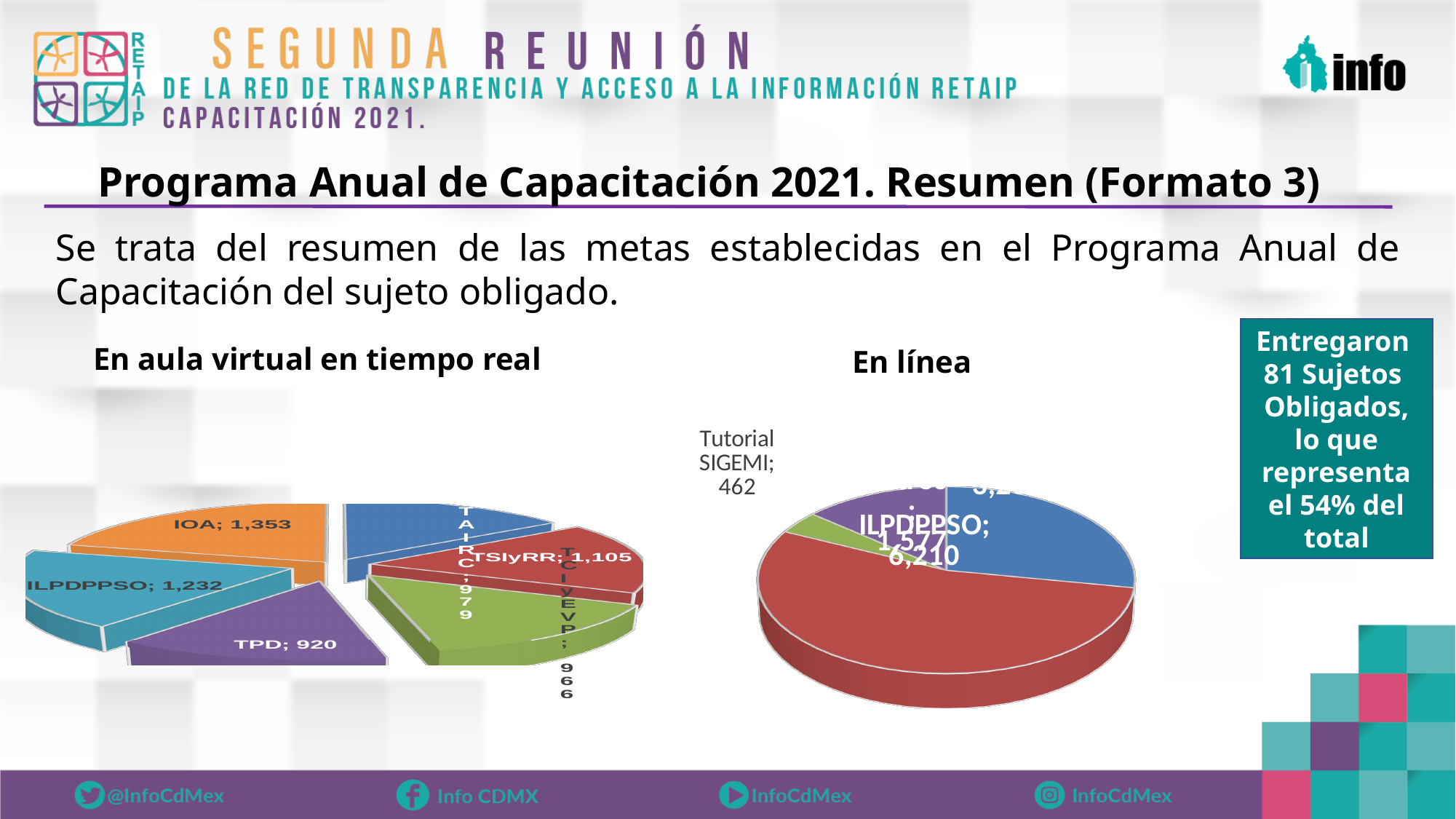
How many slices does the 'En aula virtual en tiempo real' chart have? 6 In the 'En aula virtual en tiempo real' chart, which is larger, TAIRC or TCIVEVP? TAIRC In the 'En aula virtual en tiempo real' chart, which category has the highest value? IOA In the 'En aula virtual en tiempo real' chart, which category has the lowest value? TPD In the 'En línea' chart, which category has the largest slice? ILPDPPSO In the 'En aula virtual en tiempo real' chart, what is the difference between the values for IOA and TPD? 433 What kind of chart is the 'En aula virtual en tiempo real' chart? pie chart In the 'En aula virtual en tiempo real' chart, what is the value for TSIyRR? 1,105 In the 'En línea' chart, what is the value for Tutorial SIGEMI? 462 In the 'En aula virtual en tiempo real' chart, what is the value for IOA? 1,353 In the 'En aula virtual en tiempo real' chart, what is the value for TPD? 920 In the 'En aula virtual en tiempo real' chart, what is the value for ILPDPPSO? 1,232